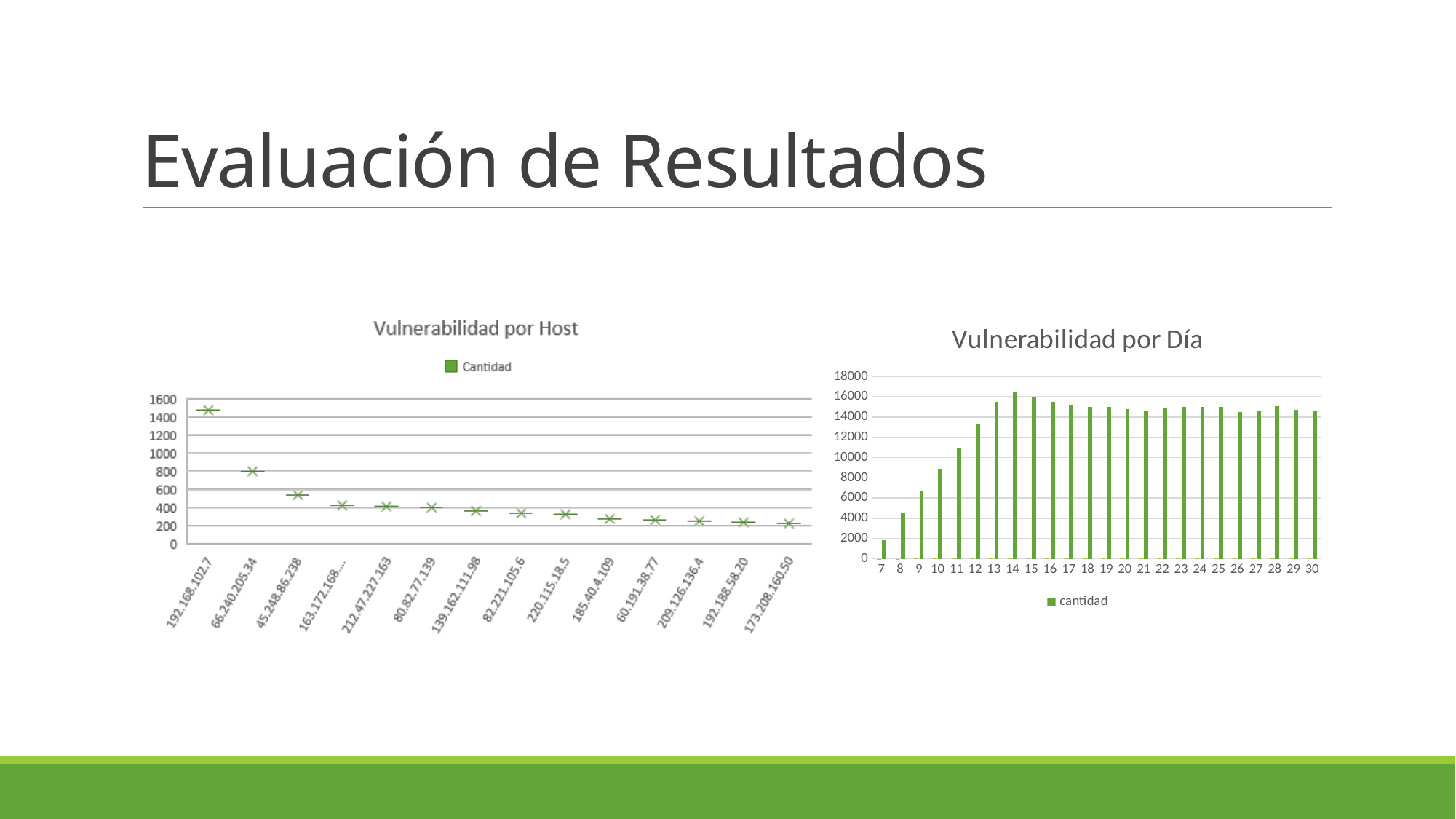
In the 'Vulnerabilidad por Día' chart, which day has the lowest value? 7 In the 'Vulnerabilidad por Host' chart, how many hosts are shown on the x axis? 14 In the 'Vulnerabilidad por Día' chart, which is larger, the value for day 9 or the value for day 11? day 11 In the 'Vulnerabilidad por Día' chart, do the values rise or fall from day 7 to day 14? rise In the 'Vulnerabilidad por Día' chart, how many days (bars) are shown on the x axis? 24 In the 'Vulnerabilidad por Día' chart, is the value for day 7 greater or less than 2000? less In the 'Vulnerabilidad por Día' chart, is the value for day 10 greater or less than 10000? less In the 'Vulnerabilidad por Día' chart, which day has the highest value? 14 In the 'Vulnerabilidad por Host' chart, which host has the highest value? 192.168.102.7 In the 'Vulnerabilidad por Host' chart, is the value for 45.248.86.238 greater or less than 400? greater What type of chart is the 'Vulnerabilidad por Día' chart? bar chart